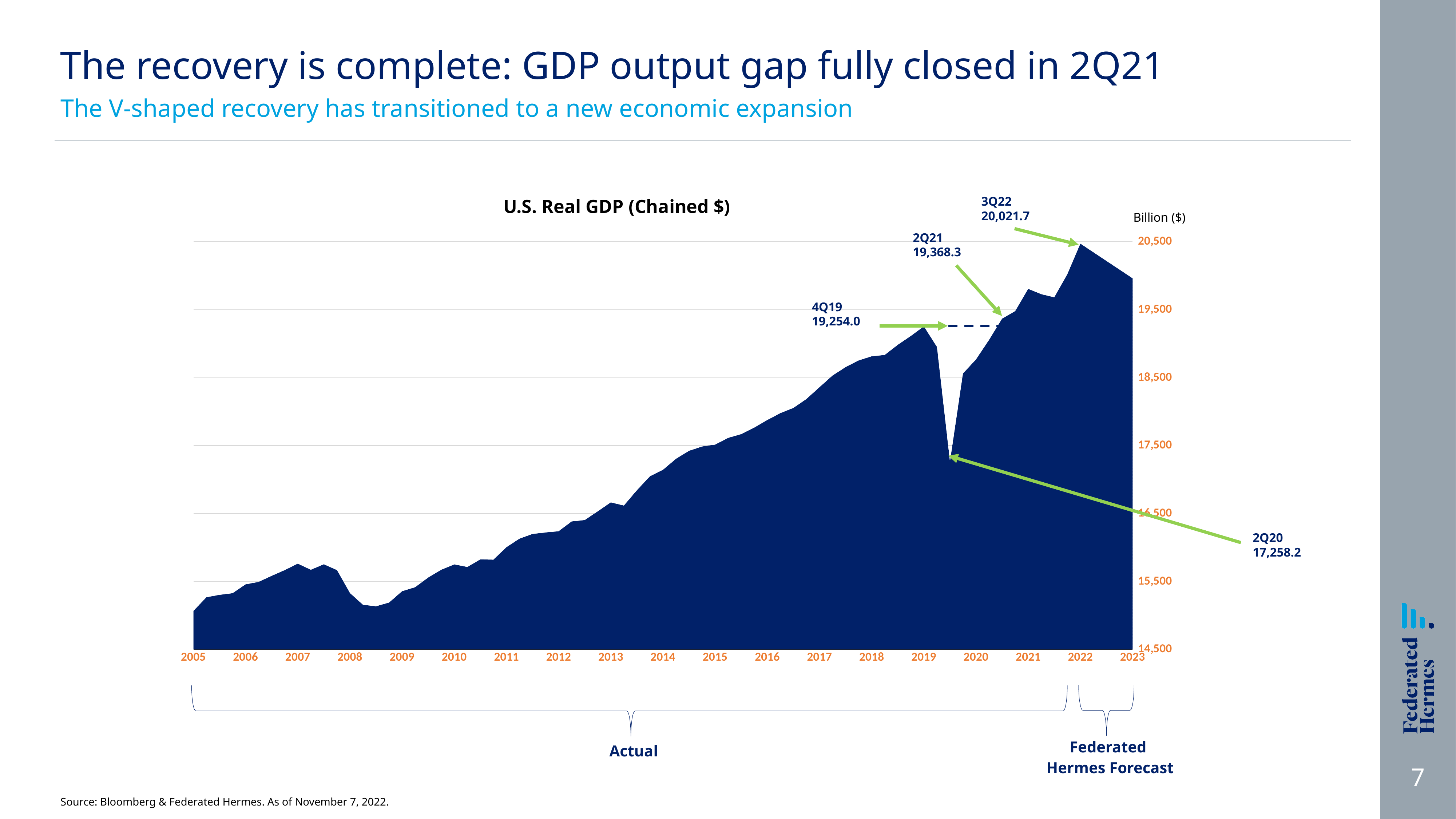
What unit is shown at the top of the right-hand axis of the chart? Billion ($) Is the value at the start of the chart in 2005 greater or less than 15,500? less Which labelled value is larger, 2Q21 or 4Q19? 2Q21 What is the value labelled for 2Q21 on the U.S. Real GDP chart? 19,368.3 What is the value labelled for 2Q20 on the U.S. Real GDP chart? 17,258.2 Of the four labelled points on the chart, which has the lowest value? 2Q20 What is the difference between the labelled values for 4Q19 and 2Q20? 1,995.8 What is the difference between the labelled values for 2Q21 and 4Q19? 114.3 What is the value labelled for 4Q19 on the U.S. Real GDP chart? 19,254.0 What type of chart is used to show U.S. Real GDP? Area chart Of the four labelled points on the chart, which has the highest value? 3Q22 What is the value labelled for 3Q22 on the U.S. Real GDP chart? 20,021.7